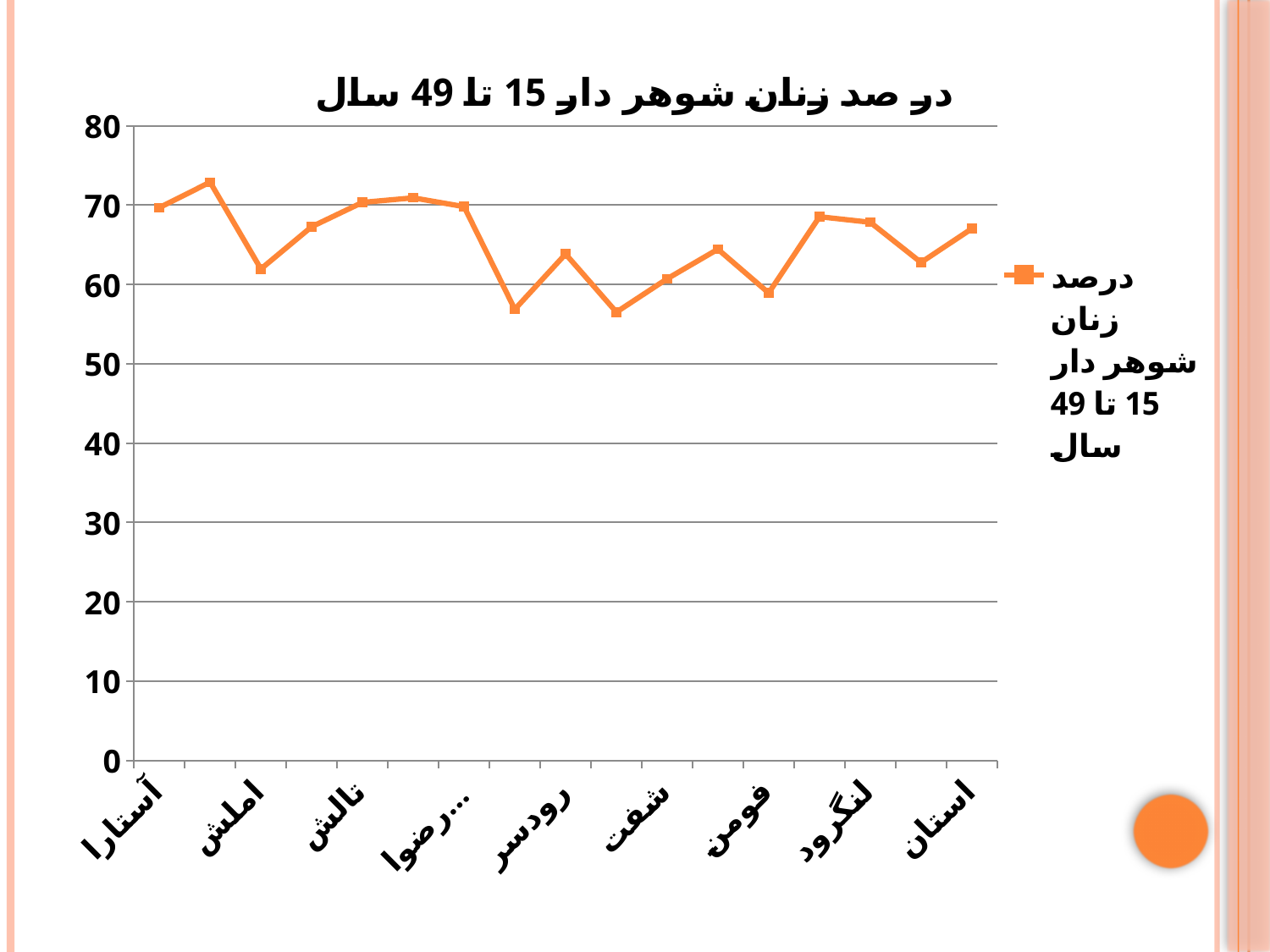
Does the value rise or fall from آستارا to املش? fall Which has the larger value, لنگرود or فومن? لنگرود Is the value for استان greater or less than 60? greater Is the value for لنگرود greater or less than 60? greater What is the title of the chart? در صد زنان شوهر دار 15 تا 49 سال Is the value for املش greater or less than 50? greater How many series does the legend list? 1 What kind of chart is shown on the slide? line chart Which has the larger value, آستارا or املش? آستارا How many data points are plotted on the line? 17